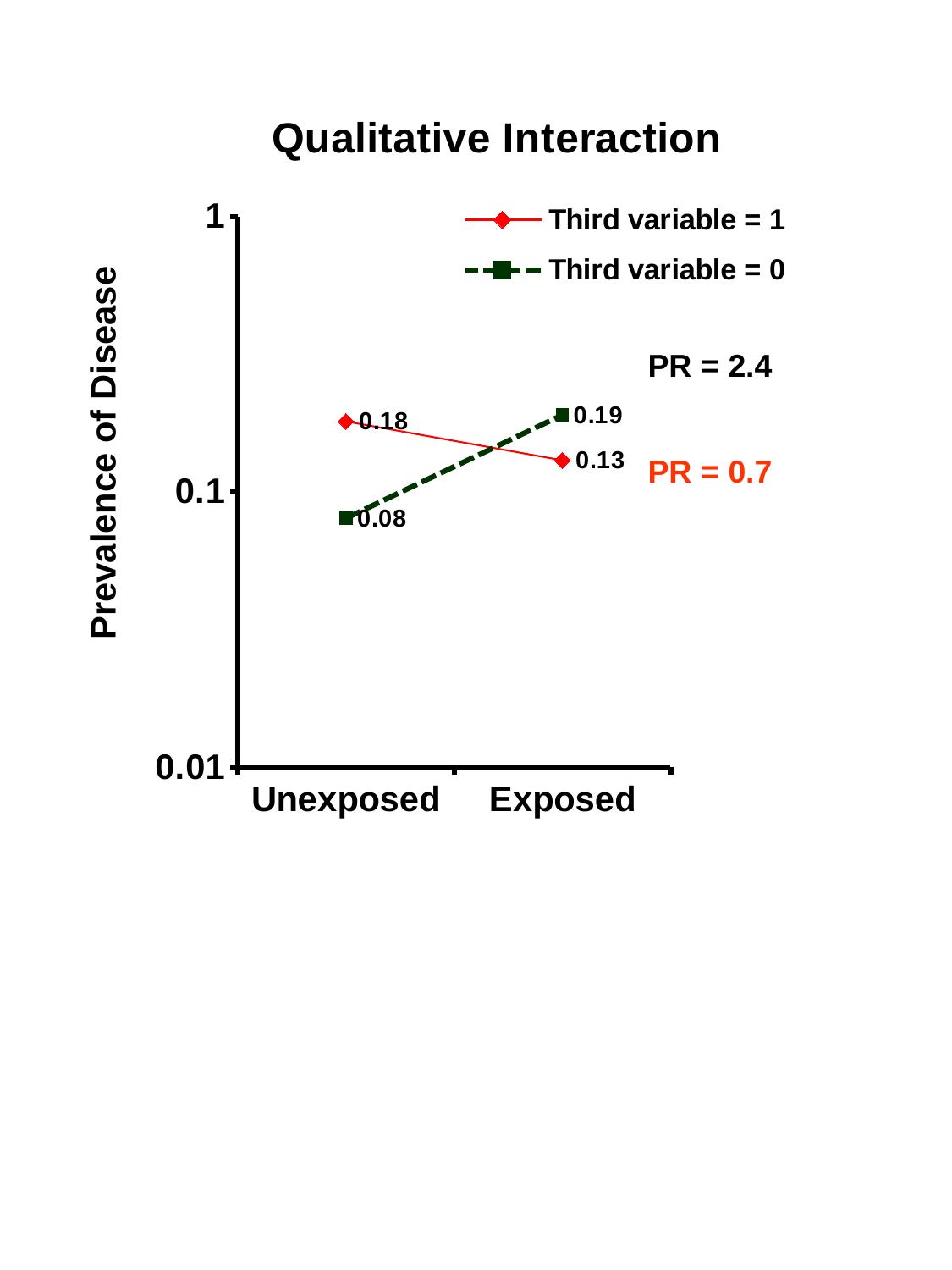
How many series does the legend list? 2 Which group has the lowest prevalence for the Third variable = 0 series? Unexposed What is the prevalence of disease for Third variable = 1 in the Unexposed group? 0.18 What is the difference in prevalence between Unexposed and Exposed for the Third variable = 1 series? 0.05 What is the prevalence of disease for Third variable = 0 in the Unexposed group? 0.08 What kind of chart is shown on the slide? line chart Does the prevalence for Third variable = 0 rise or fall from Unexposed to Exposed? rise What is the prevalence of disease for Third variable = 1 in the Exposed group? 0.13 Does the prevalence for Third variable = 1 rise or fall from Unexposed to Exposed? fall What is the title of the chart? Qualitative Interaction In the Unexposed group, which series has the higher prevalence, Third variable = 1 or Third variable = 0? Third variable = 1 What is the prevalence of disease for Third variable = 0 in the Exposed group? 0.19